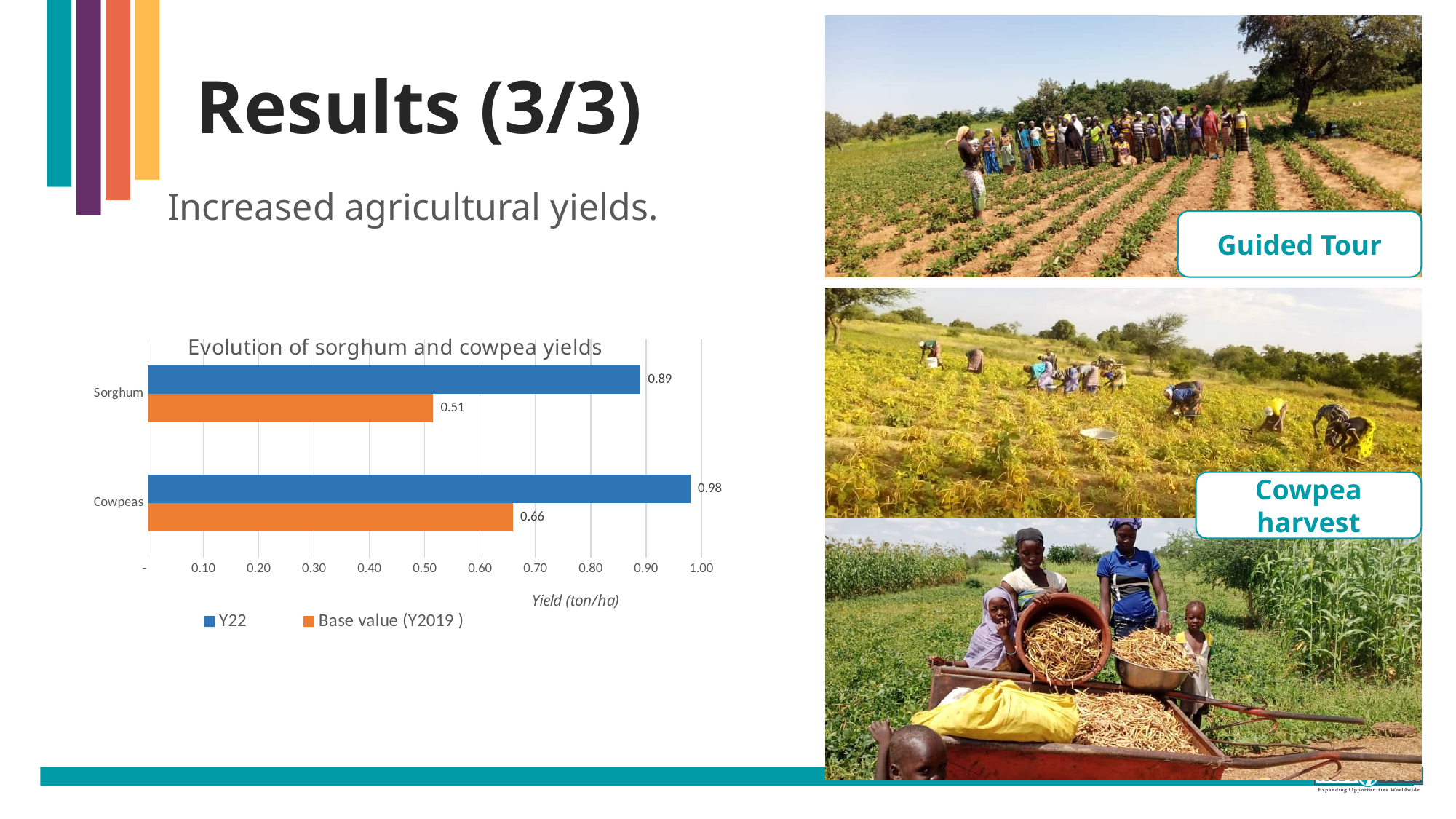
Is the Y22 yield for Cowpeas larger or smaller than the Base value (Y2019) yield for Cowpeas? larger Which crop has the lowest Base value (Y2019) yield? Sorghum What is the Y22 yield for Cowpeas? 0.98 How many crop categories are shown in the chart? 2 What is the Y22 yield for Sorghum? 0.89 What is the Base value (Y2019) yield for Cowpeas? 0.66 What is the difference between the Y22 and Base value (Y2019) yields for Sorghum? 0.38 Which crop has the higher Y22 yield? Cowpeas What is the difference between the Y22 and Base value (Y2019) yields for Cowpeas? 0.32 How many series does the chart legend list? 2 What is the Base value (Y2019) yield for Sorghum? 0.51 What type of chart is used to show the evolution of sorghum and cowpea yields? Bar chart